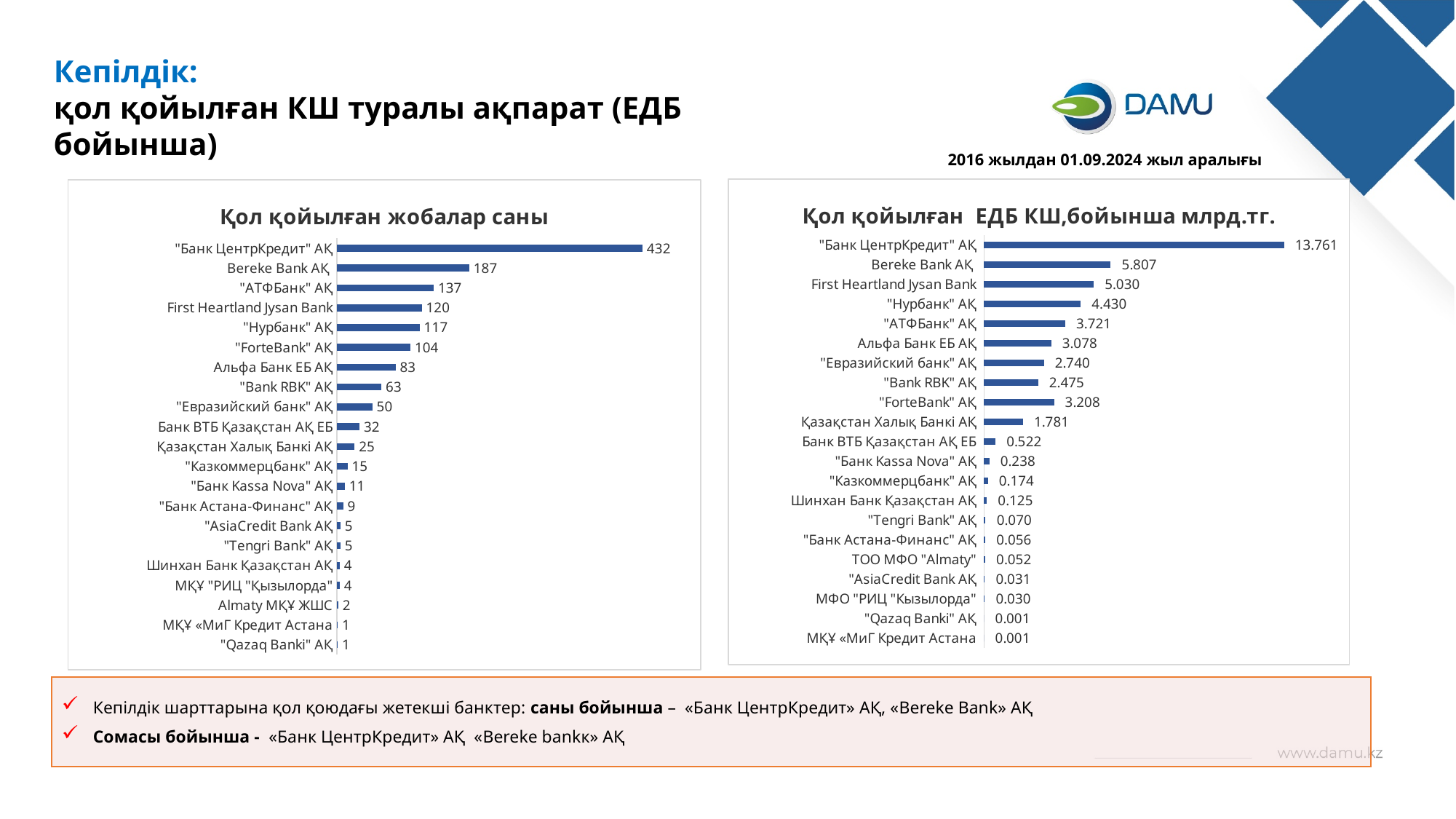
In the chart "Қол қойылған жобалар саны", what is the difference between "АТФБанк" АҚ and "Нурбанк" АҚ? 20 In the chart "Қол қойылған ЕДБ КШ,бойынша млрд.тг.", what is the value for "Банк ЦентрКредит" АҚ? 13.761 In the chart "Қол қойылған ЕДБ КШ,бойынша млрд.тг.", what is the value for Банк ВТБ Қазақстан АҚ ЕБ? 0.522 In the chart "Қол қойылған жобалар саны", which is larger: "ForteBank" АҚ or Альфа Банк ЕБ АҚ? "ForteBank" АҚ What type of chart is "Қол қойылған жобалар саны"? Bar chart In the chart "Қол қойылған ЕДБ КШ,бойынша млрд.тг.", what is the difference between Bereke Bank АҚ and First Heartland Jysan Bank? 0.777 In the chart "Қол қойылған жобалар саны", which bank has the highest value? "Банк ЦентрКредит" АҚ How many banks are listed in the chart "Қол қойылған жобалар саны"? 21 What period is stated above the charts on the slide? 2016 жылдан 01.09.2024 жыл аралығы In the chart "Қол қойылған жобалар саны", what is the value for "Bereke Bank АҚ"? 187 In the chart "Қол қойылған ЕДБ КШ,бойынша млрд.тг.", which is larger: "Евразийский банк" АҚ or "Bank RBK" АҚ? "Евразийский банк" АҚ In the chart "Қол қойылған ЕДБ КШ,бойынша млрд.тг.", what is the value for "ForteBank" АҚ? 3.208